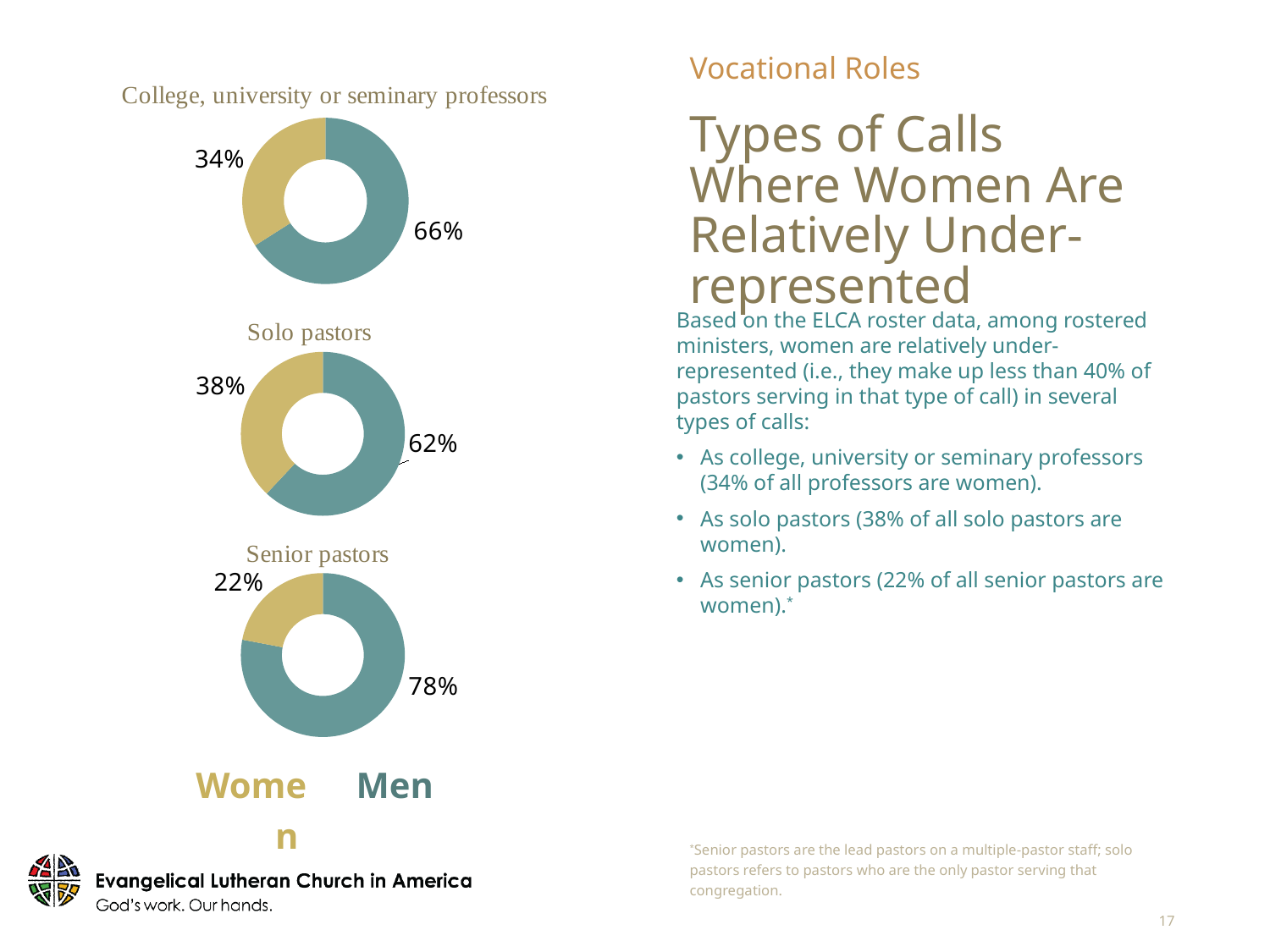
In the 'Solo pastors' chart, what percentage is shown for Women? 38% How many series does the shared legend below the charts list? 2 In the 'Senior pastors' chart, which group has the larger share, Women or Men? Men What kind of chart is used for 'Solo pastors'? Donut (pie) chart In the 'Senior pastors' chart, what is the difference in percentage points between Men and Women? 56 In the 'College, university or seminary professors' chart, what percentage is shown for Men? 66% In the 'Solo pastors' chart, what percentage is shown for Men? 62% Across the three charts, which type of call has the lowest share of Women? Senior pastors In the 'Senior pastors' chart, what percentage is shown for Women? 22% In the 'College, university or seminary professors' chart, what percentage is shown for Women? 34% In the 'Senior pastors' chart, what percentage is shown for Men? 78% In the 'Solo pastors' chart, what is the difference in percentage points between Men and Women? 24